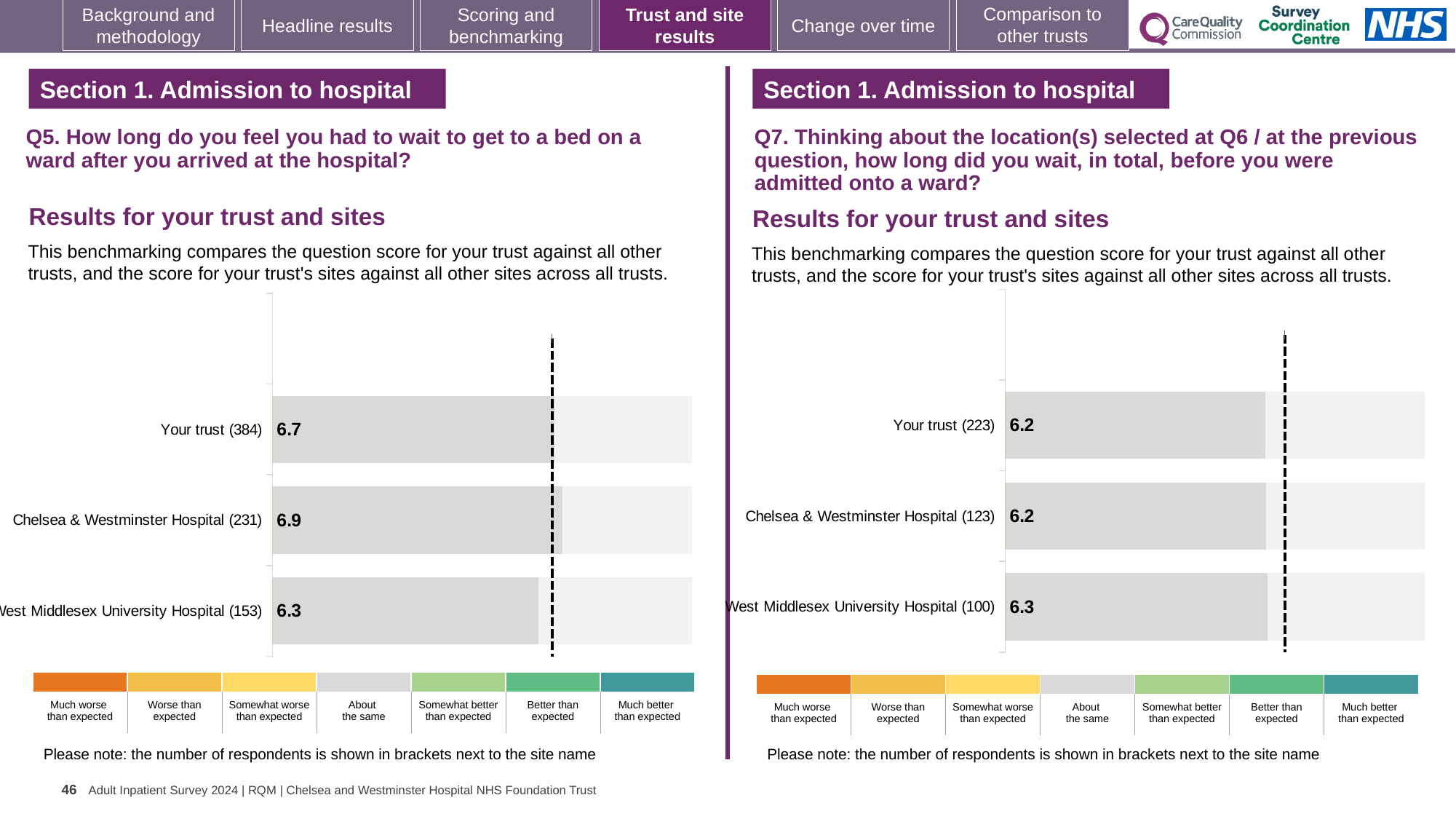
In the Q7 chart on the right, which site or trust has the highest score? West Middlesex University Hospital (100) In the Q7 chart on the right, which is larger: the score for Your trust or the score for West Middlesex University Hospital? West Middlesex University Hospital In the Q7 chart on the right, what is the score for Your trust (223)? 6.2 In the Q5 chart on the left, what is the score for Your trust (384)? 6.7 In the Q5 chart on the left, what is the difference between the scores for Chelsea & Westminster Hospital and West Middlesex University Hospital? 0.6 How many bars are plotted in the Q7 chart on the right? 3 In the Q5 chart on the left, which site or trust has the highest score? Chelsea & Westminster Hospital (231) In the Q5 chart on the left, what is the score for West Middlesex University Hospital (153)? 6.3 In the Q5 chart on the left, which site or trust has the lowest score? West Middlesex University Hospital (153) In the Q7 chart on the right, what is the score for West Middlesex University Hospital (100)? 6.3 In the Q5 chart on the left, what is the score for Chelsea & Westminster Hospital (231)? 6.9 What kind of chart is used in the Q5 chart on the left? Bar chart